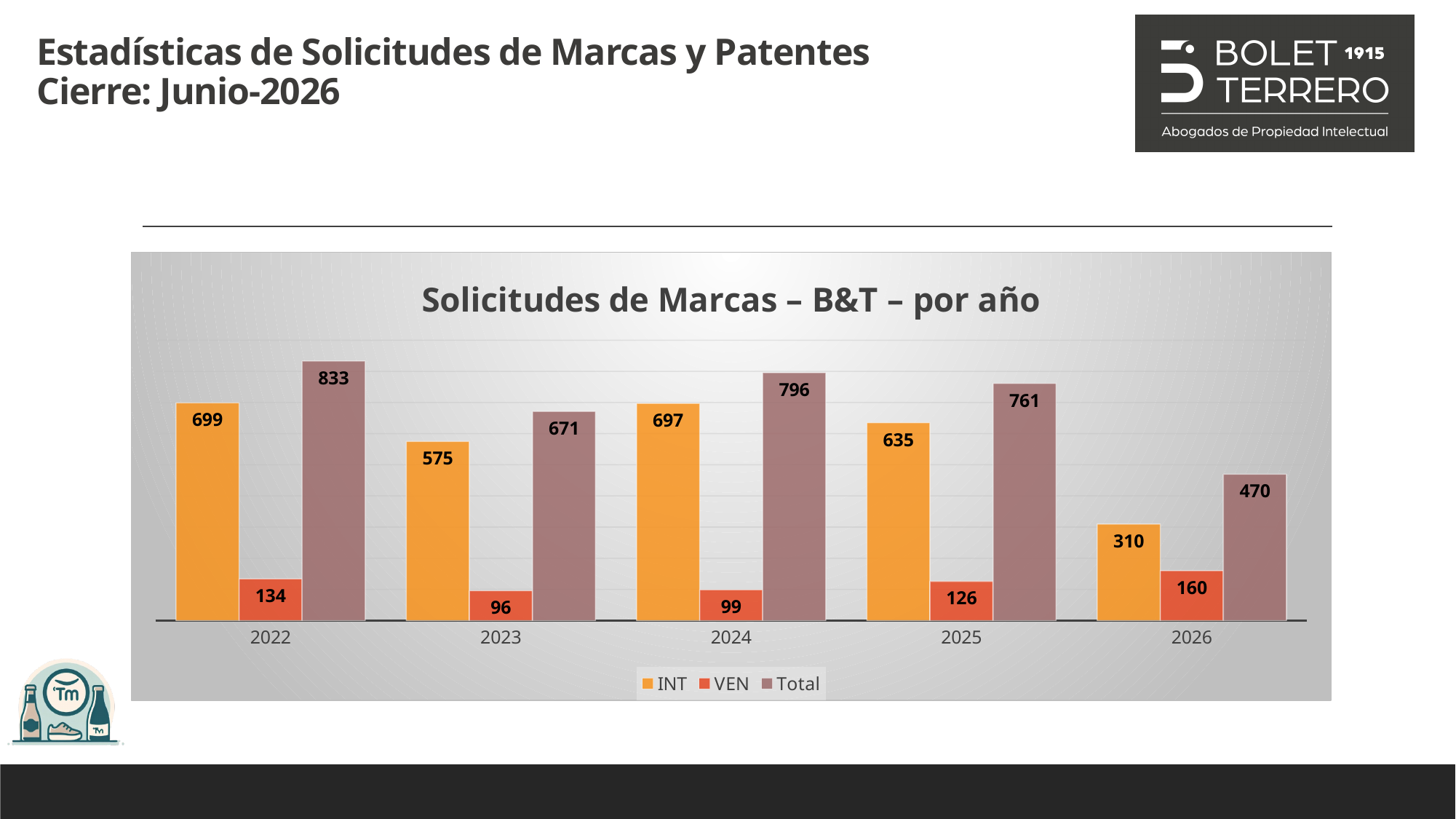
What kind of chart is shown? Bar chart Which is larger, the VEN value for 2022 or the VEN value for 2026? VEN value for 2026 What is the INT value for 2022? 699 What is the difference between the INT and VEN values for 2024? 598 What is the title of the chart? Solicitudes de Marcas – B&T – por año Which year has the highest Total value? 2022 Does the Total value rise or fall from 2025 to 2026? Fall How many years are shown on the x axis? 5 What is the Total value for 2025? 761 How many series does the legend list? 3 Which year has the lowest INT value? 2026 What is the VEN value for 2023? 96